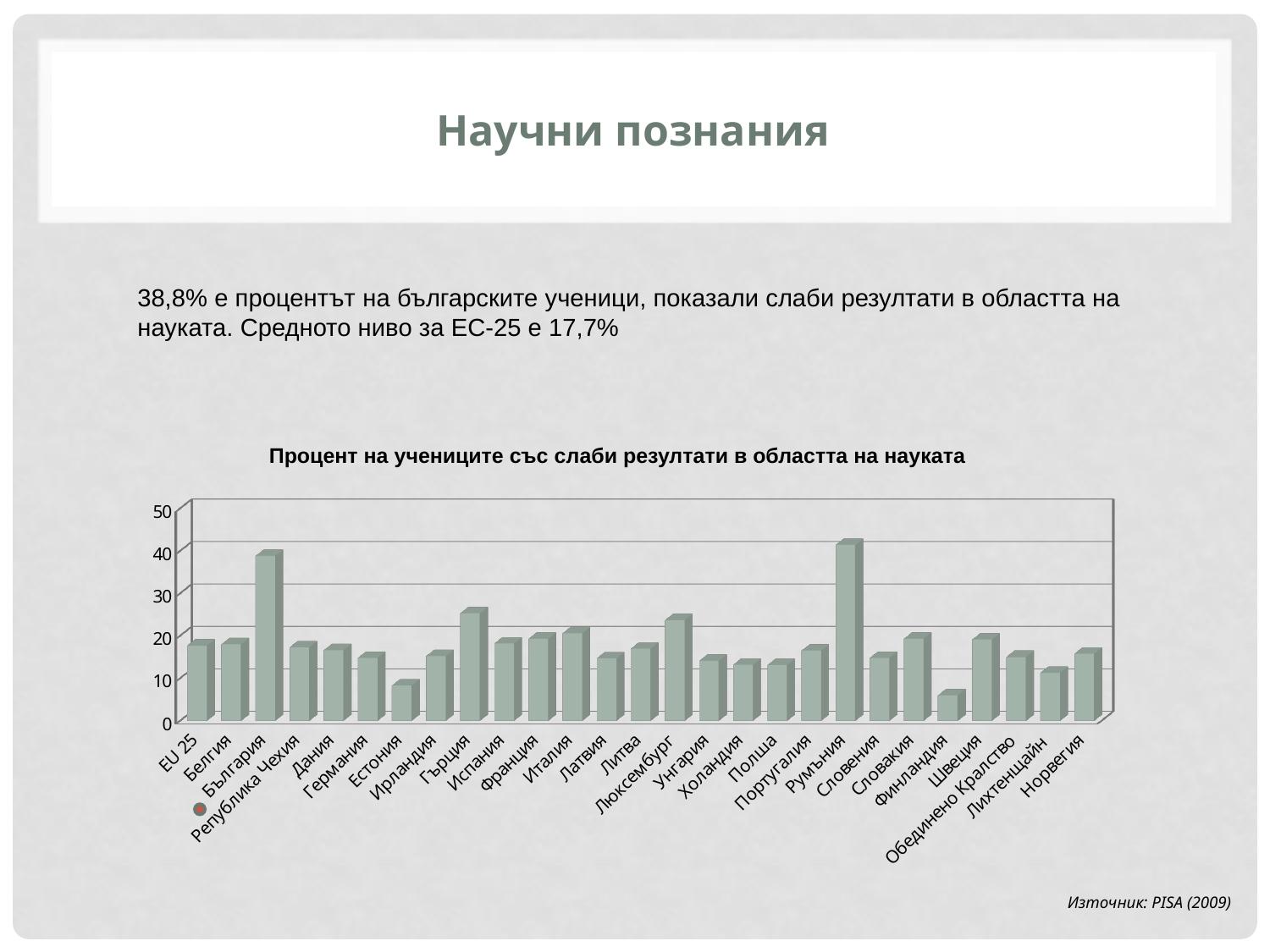
Is the value for България greater or less than 30? greater What kind of chart is shown on the slide? bar chart How many countries/categories are shown on the x axis of the chart? 27 Which country has the lowest bar in the chart? Финландия Which has a higher value, Люксембург or Унгария? Люксембург What is the average level for EU-25, as stated on the slide? 17,7% What is the percentage of Bulgarian students with weak results in science, as stated on the slide? 38,8% Is the value for Финландия greater or less than 10? less Is the value for Гърция greater or less than 20? greater Which country has the highest bar in the chart? Румъния What is the title of the chart? Процент на учениците със слаби резултати в областта на науката Which has a higher value, Гърция or Испания? Гърция